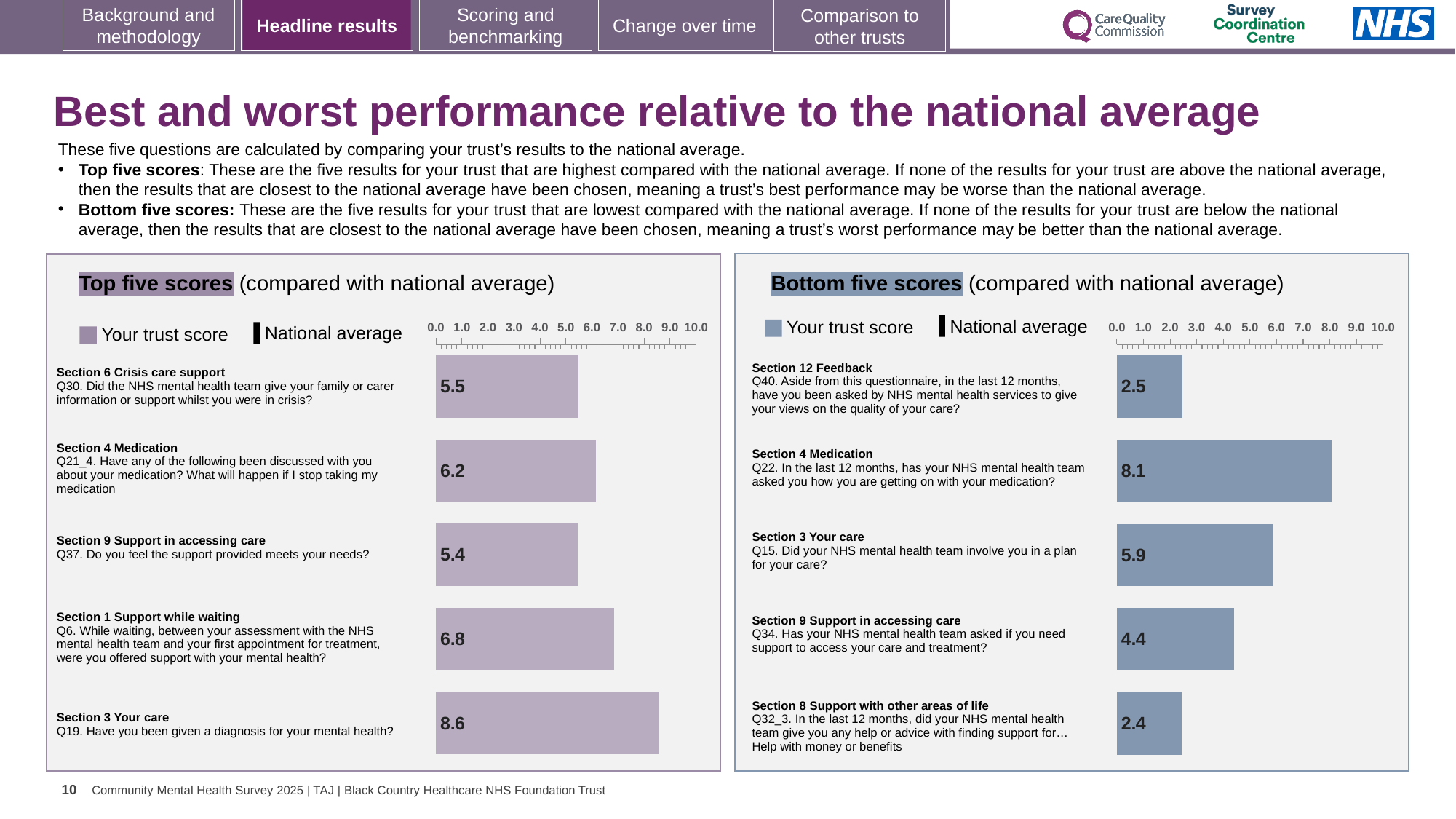
In the Top five scores chart, what is the trust score for Q30 (Did the NHS mental health team give your family or carer information or support whilst you were in crisis?)? 5.5 In the Bottom five scores chart, which has the larger trust score, Q15 or Q34? Q15 In the Top five scores chart, is the trust score for Q6 greater or less than 5.0? greater In the Top five scores chart, what is the difference between the trust scores for Q19 and Q30? 3.1 In the Bottom five scores chart, what is the trust score for Q32_3 (help with money or benefits)? 2.4 In the Bottom five scores chart, which question has the highest trust score? Q22 In the Bottom five scores chart, what is the trust score for Q22 (has your NHS mental health team asked you how you are getting on with your medication?)? 8.1 In the Top five scores chart, which question has the highest trust score? Q19 What kind of chart is the Top five scores chart? Bar chart In the Top five scores chart, what is the trust score for Q19 (Have you been given a diagnosis for your mental health?)? 8.6 In the Top five scores chart, which question has the lowest trust score? Q37 How many bars are plotted in the Bottom five scores chart? 5